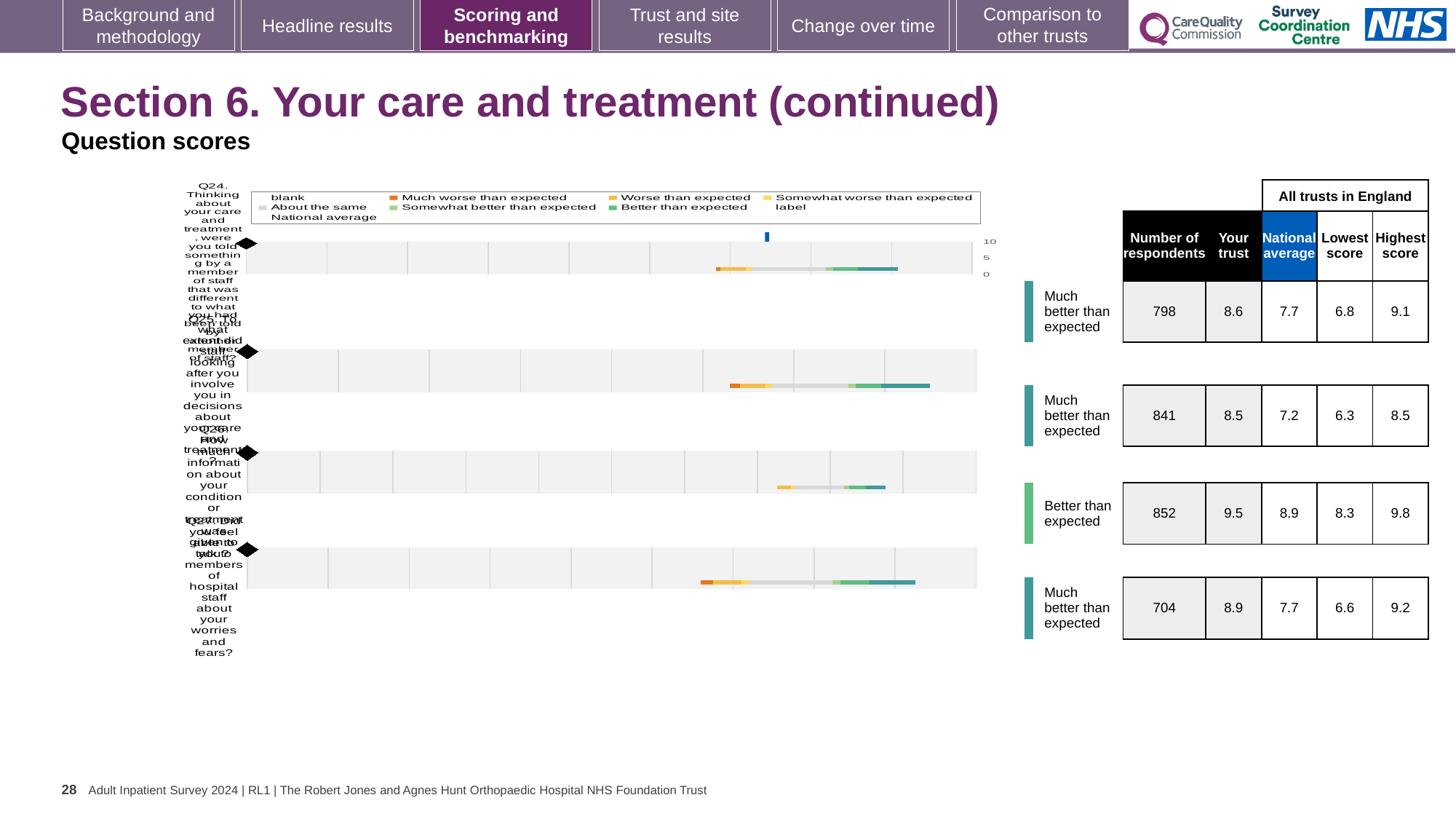
What is the national average for the third row (Q26) in the question scores chart? 8.9 For the second row (Q25), what is the difference between the highest score and the lowest score among all trusts in England? 2.2 What benchmark category is shown for the third row (Q26)? Better than expected Which question row has the lowest 'Your trust' score? Q25 (second row) What kind of chart is used to show the question scores on this slide? bar chart How many questions (rows) are plotted in the question scores chart? 4 For the fourth row (Q27), which is larger: the 'Your trust' score or the national average? Your trust How many respondents are shown for the second row (Q25)? 841 Which question row has the highest 'Your trust' score? Q26 (third row) What is the 'Your trust' score for the first row (Q24) in the question scores chart? 8.6 For the first row (Q24), how much higher is the 'Your trust' score than the national average? 0.9 What is the highest score among all trusts in England for the third row (Q26)? 9.8